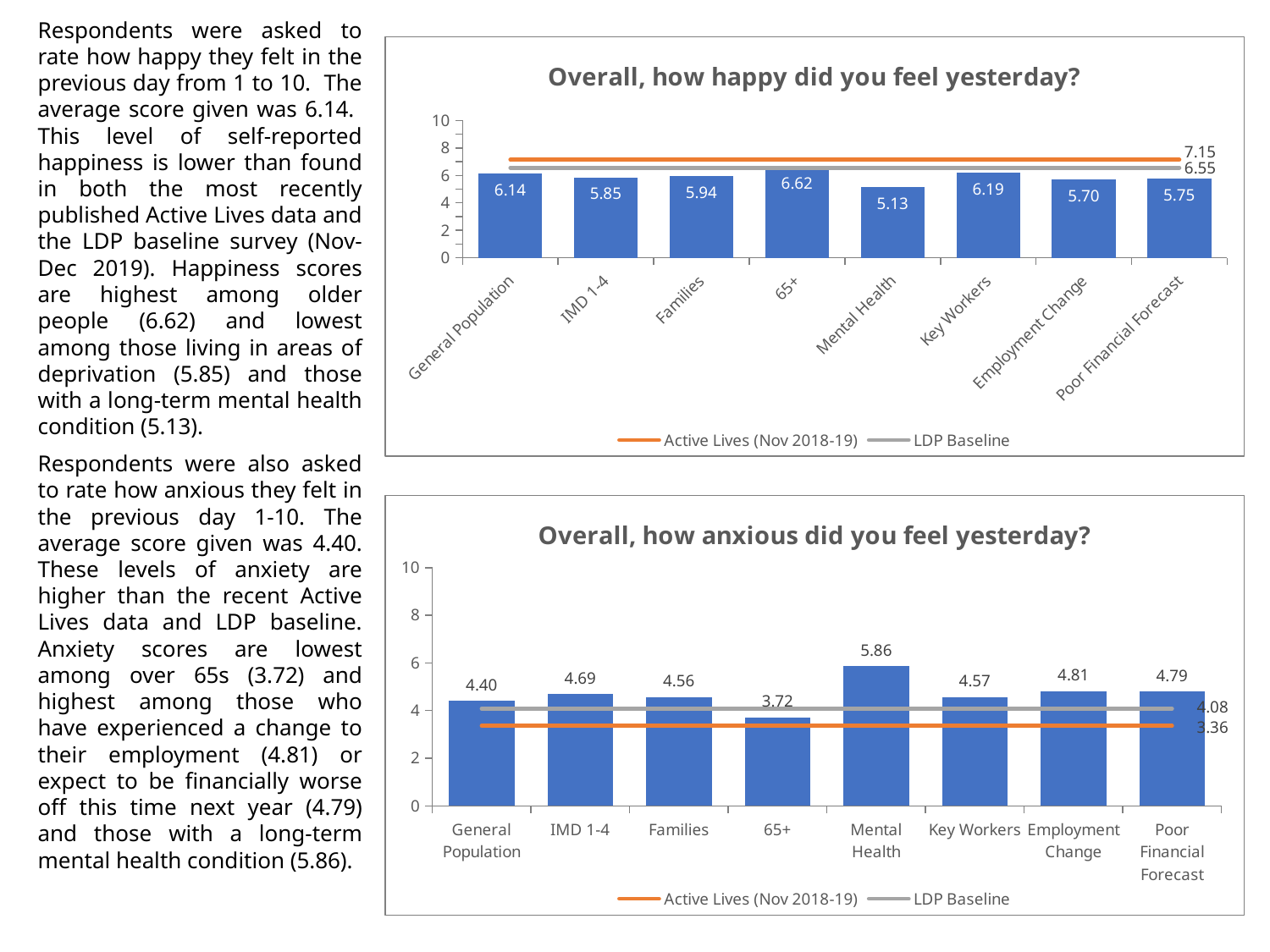
In the 'Overall, how anxious did you feel yesterday?' chart, what value is shown for the LDP Baseline line? 4.08 In the 'Overall, how anxious did you feel yesterday?' chart, what is the value for Employment Change? 4.81 In the 'Overall, how anxious did you feel yesterday?' chart, how many categories are shown on the x axis? 8 In the 'Overall, how anxious did you feel yesterday?' chart, which is larger, the value for IMD 1-4 or the value for Families? IMD 1-4 In the 'Overall, how anxious did you feel yesterday?' chart, which category has the lowest bar? 65+ In the 'Overall, how happy did you feel yesterday?' chart, what value is shown for the Active Lives (Nov 2018-19) line? 7.15 In the 'Overall, how happy did you feel yesterday?' chart, what is the value for Mental Health? 5.13 In the 'Overall, how happy did you feel yesterday?' chart, what is the difference between the 65+ value and the Mental Health value? 1.49 In the 'Overall, how happy did you feel yesterday?' chart, which category has the highest bar? 65+ What kind of chart is the 'Overall, how anxious did you feel yesterday?' chart? Bar chart In the 'Overall, how happy did you feel yesterday?' chart, how many series does the legend list? 2 In the 'Overall, how anxious did you feel yesterday?' chart, is the value for Mental Health greater or less than 4? greater